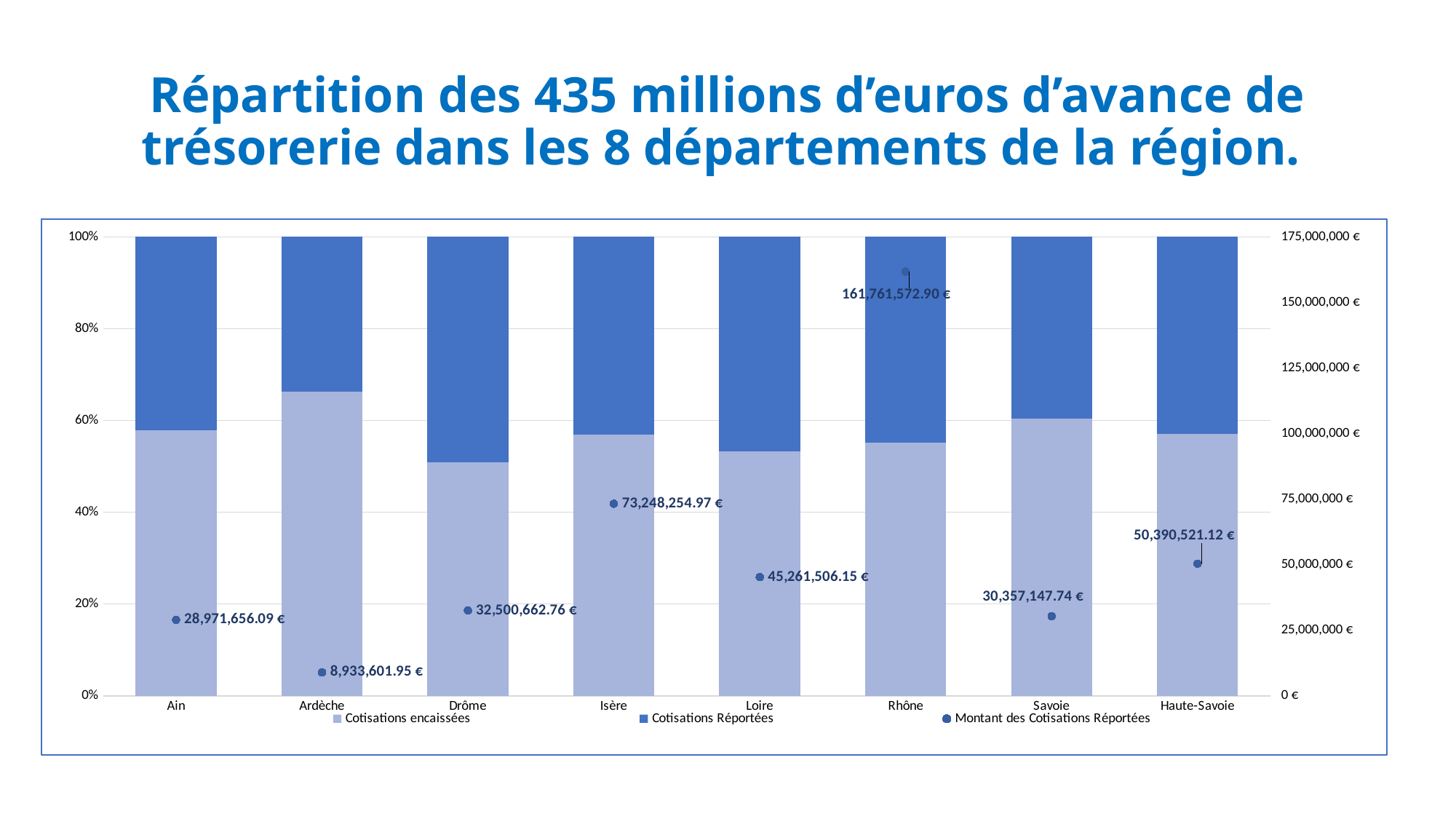
Which department has the lowest Montant des Cotisations Réportées? Ardèche How many series does the chart legend list? 3 Which has a larger Montant des Cotisations Réportées, Haute-Savoie or Loire? Haute-Savoie Which department has the highest Montant des Cotisations Réportées? Rhône What is the Montant des Cotisations Réportées for Rhône? 161,761,572.90 € How many departments are shown on the x axis of the chart? 8 What is the Montant des Cotisations Réportées for Isère? 73,248,254.97 € What is the difference between the Montant des Cotisations Réportées for Isère and for Loire? 27,986,748.82 € What is the Montant des Cotisations Réportées for Haute-Savoie? 50,390,521.12 € What kind of chart is shown on the slide? Stacked bar chart What is the Montant des Cotisations Réportées for Ardèche? 8,933,601.95 € Is the Cotisations encaissées share for Ardèche greater or less than 60%? greater